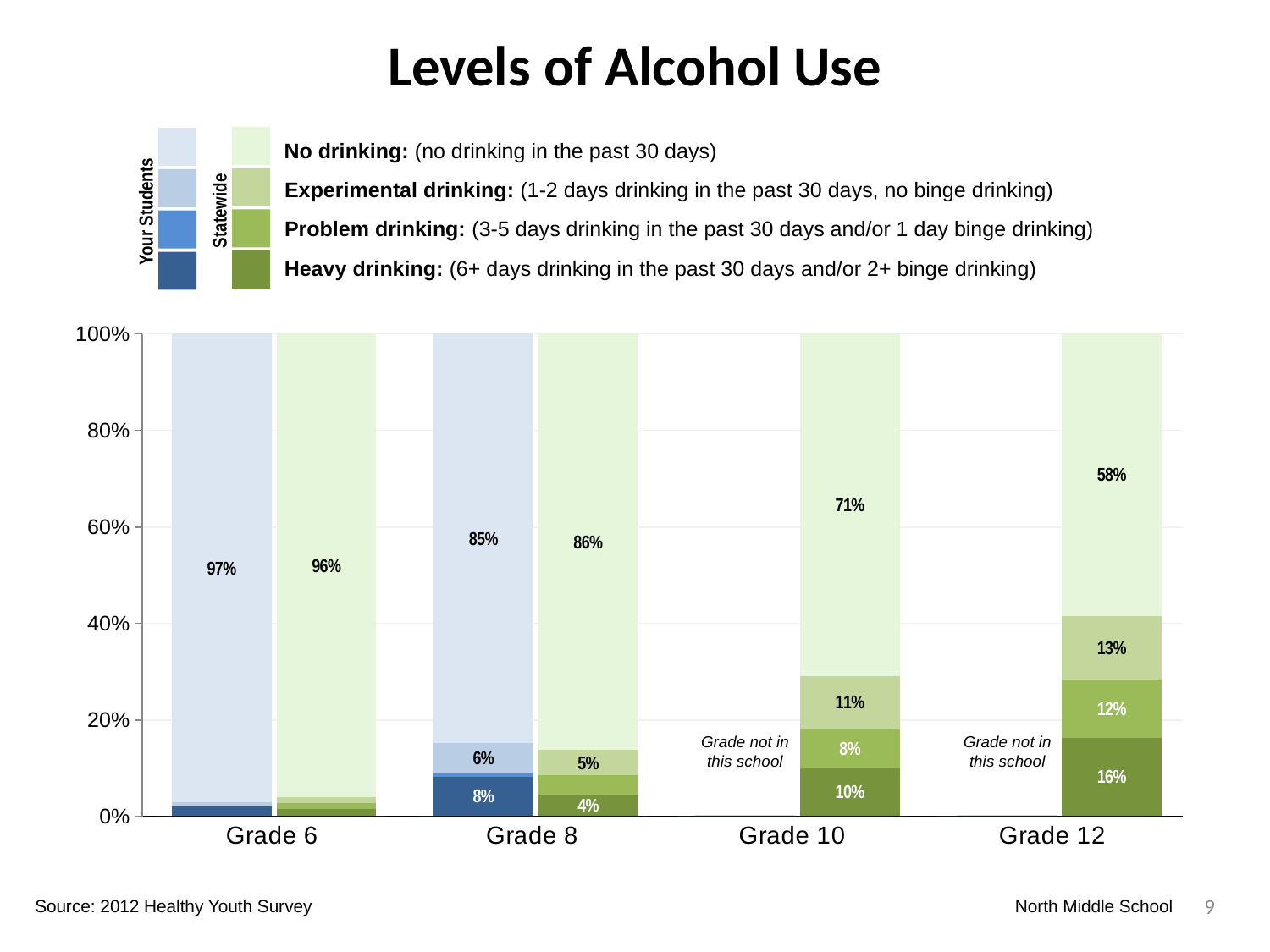
Which grade has the lowest Statewide percentage for no drinking? Grade 12 What is the Statewide percentage for no drinking in Grade 12? 58% What percentage of Your Students in Grade 8 reported heavy drinking? 8% What is the difference between the Statewide no drinking percentages for Grade 10 and Grade 12? 13% How many grade categories are shown on the x axis? 4 Which is larger for Grade 8 heavy drinking: Your Students or Statewide? Your Students What is shown in place of the Your Students bar for Grade 10 and Grade 12? Grade not in this school Which grade has the highest Statewide percentage for heavy drinking? Grade 12 What kind of chart is shown on the slide? Stacked bar chart What is the Statewide percentage for heavy drinking in Grade 10? 10% Is the Statewide no drinking value for Grade 10 greater or less than 60%? greater What percentage of Your Students in Grade 6 reported no drinking? 97%